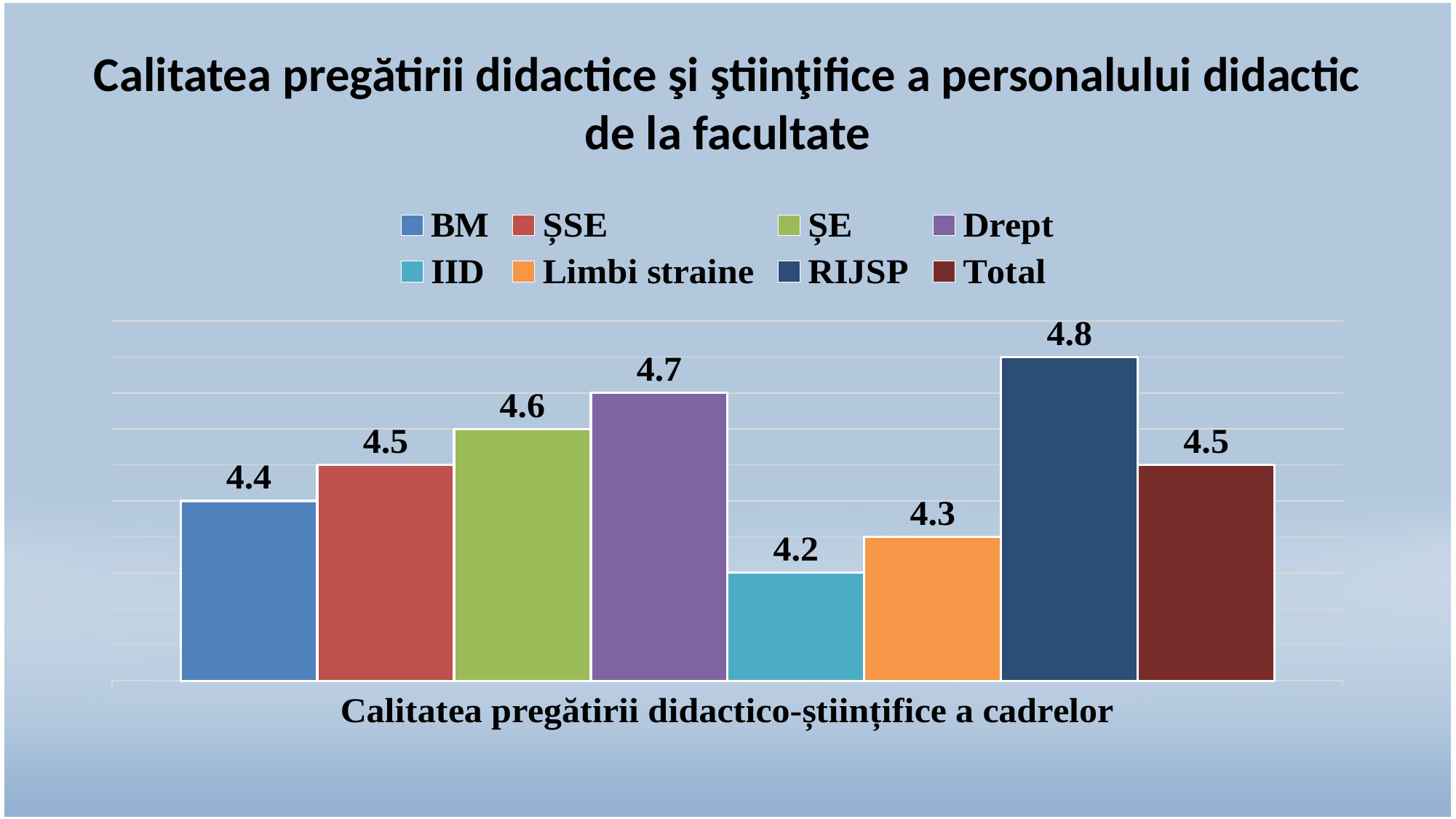
What is the value for IID? 4.2 Which series has the lowest value? IID Which is larger, the value for ȘSE or the value for Drept? Drept What kind of chart is shown on the slide? Bar chart What is the value for Limbi straine? 4.3 What is the value for Drept? 4.7 How many series does the legend list? 8 What is the value for RIJSP? 4.8 Which series has the highest value? RIJSP What is the label shown on the x axis of the chart? Calitatea pregătirii didactico-științifice a cadrelor What is the difference between the values for ȘE and BM? 0.2 What is the difference between the values for RIJSP and IID? 0.6